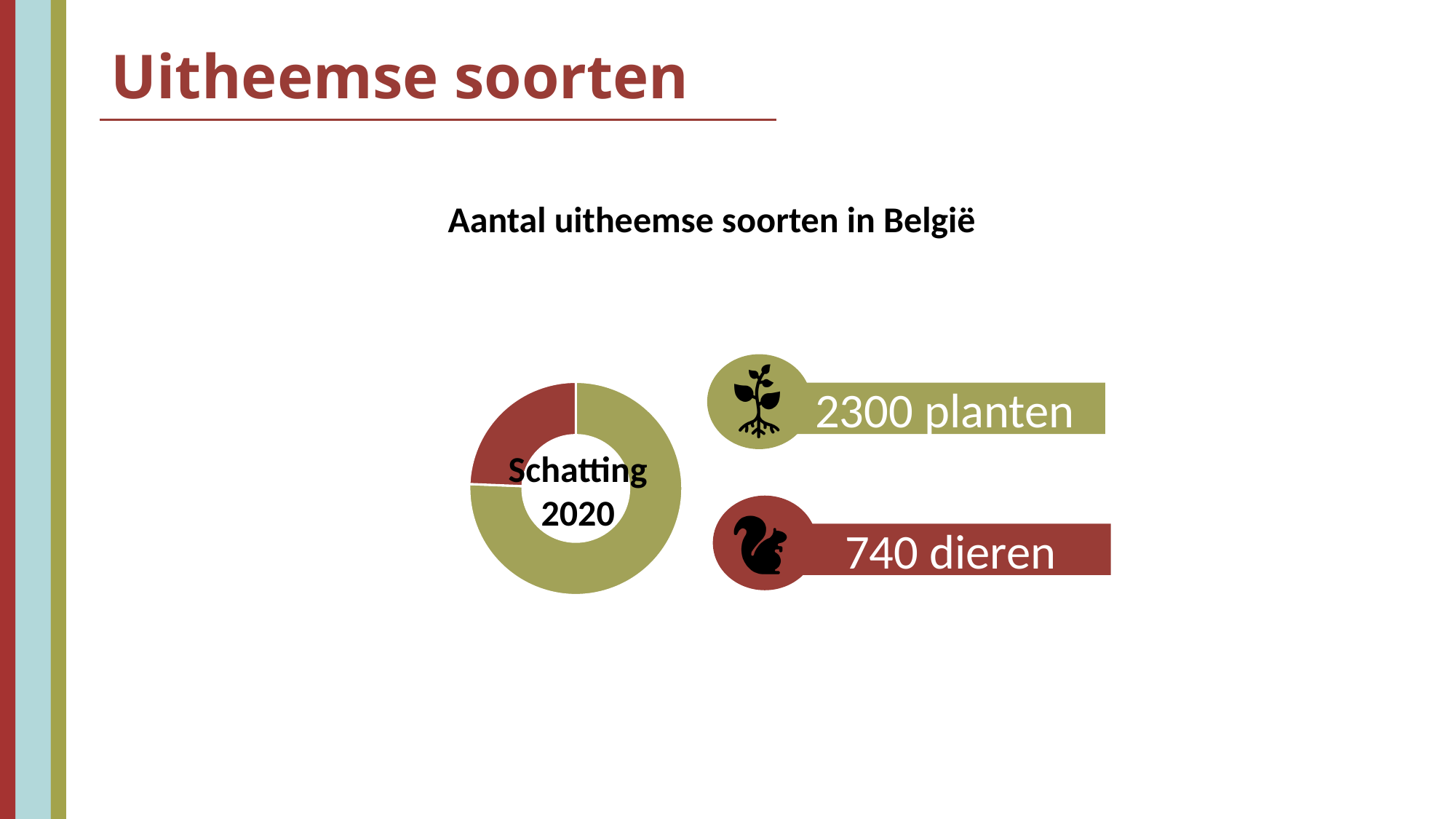
What is the title of the chart? Aantal uitheemse soorten in België What text is written in the centre of the donut chart? Schatting 2020 How many categories does the chart show? 2 What kind of chart is shown on the slide? pie chart (donut) Which category has the larger value, planten or dieren? planten How many animal species (dieren) does the chart show? 740 How many plant species (planten) does the chart show? 2300 What is the difference between the number of planten and the number of dieren? 1560 Which category has the smallest value in the chart? dieren Is the value for dieren larger or smaller than the value for planten? smaller What is the total number of uitheemse soorten shown (planten plus dieren)? 3040